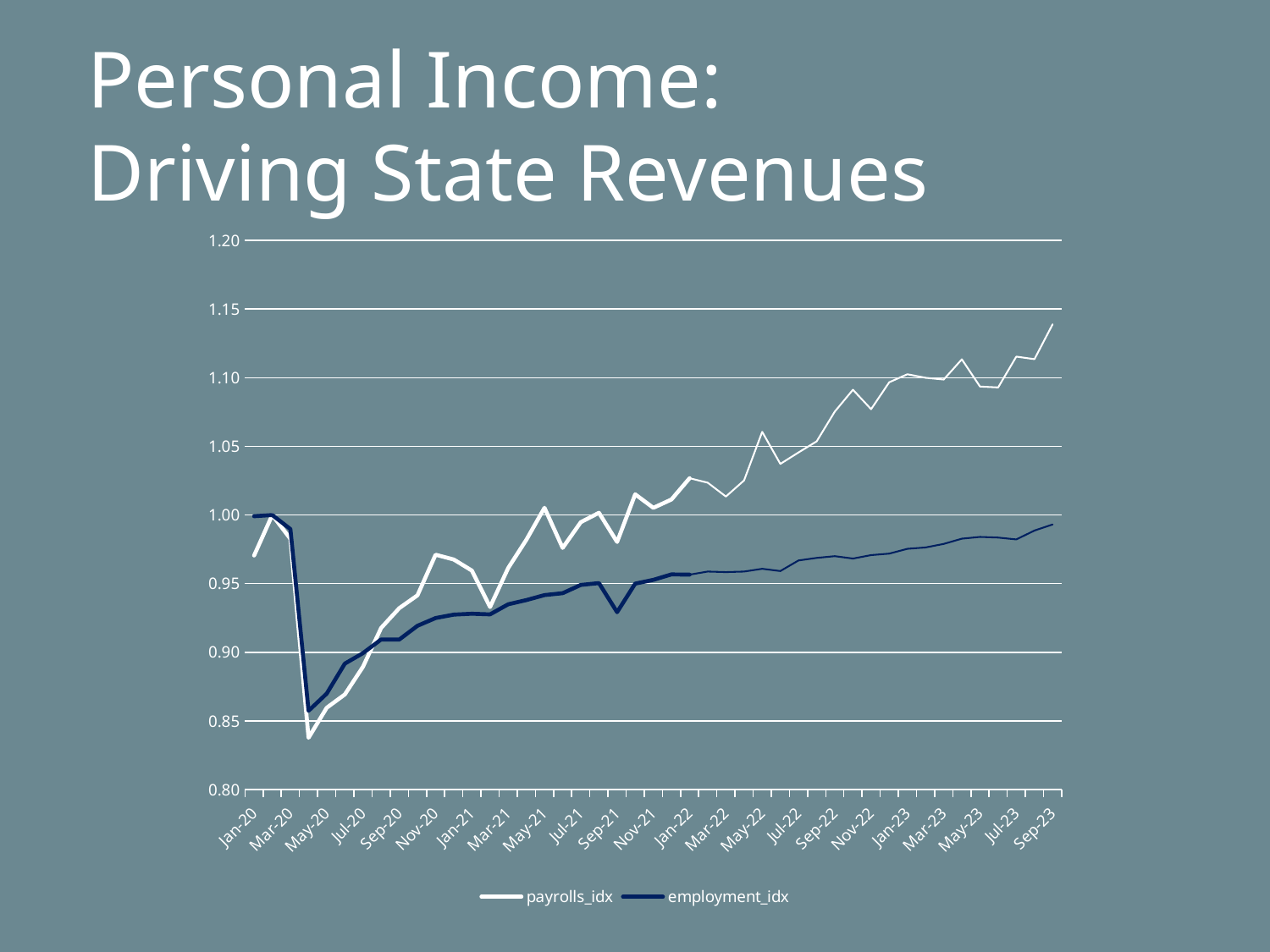
Is the value of employment_idx at Sep-23 greater or less than 1.00? less Is the value of employment_idx at Sep-21 greater or less than 0.95? less What are the two series named in the legend? payrolls_idx and employment_idx Is the value of payrolls_idx at Sep-23 greater or less than 1.10? greater What is the title of the slide containing the chart? Personal Income: Driving State Revenues At which month does payrolls_idx reach its lowest value? Apr-20 How many series does the legend list? 2 At Sep-23, which series has the higher value, payrolls_idx or employment_idx? payrolls_idx What kind of chart is shown on the slide? line chart From May-20 to Sep-23, does payrolls_idx generally rise or fall? rise